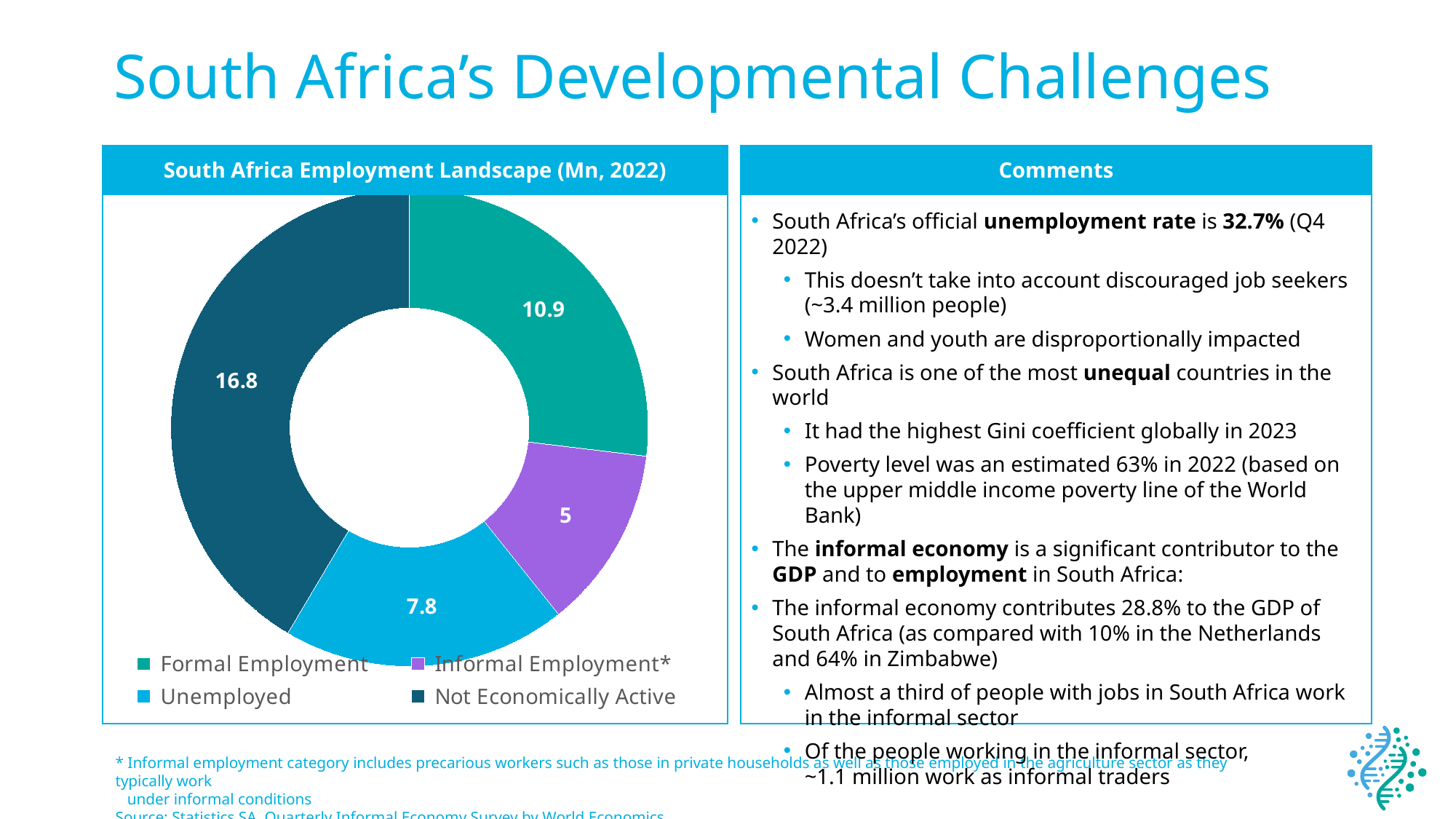
What is the value for Unemployed in the South Africa Employment Landscape chart? 7.8 What kind of chart is the South Africa Employment Landscape chart? Doughnut chart What is the difference between the Unemployed and Informal Employment* values in the South Africa Employment Landscape chart? 2.8 What is the title of the chart on the left of the slide? South Africa Employment Landscape (Mn, 2022) Which category has the smallest value in the South Africa Employment Landscape chart? Informal Employment* What is the difference between the Not Economically Active and Formal Employment values in the South Africa Employment Landscape chart? 5.9 How many categories are shown in the South Africa Employment Landscape chart? 4 What is the value for Formal Employment in the South Africa Employment Landscape chart? 10.9 What is the value for Informal Employment* in the South Africa Employment Landscape chart? 5 What is the value for Not Economically Active in the South Africa Employment Landscape chart? 16.8 Which is larger in the South Africa Employment Landscape chart, Formal Employment or Unemployed? Formal Employment Which category has the largest value in the South Africa Employment Landscape chart? Not Economically Active